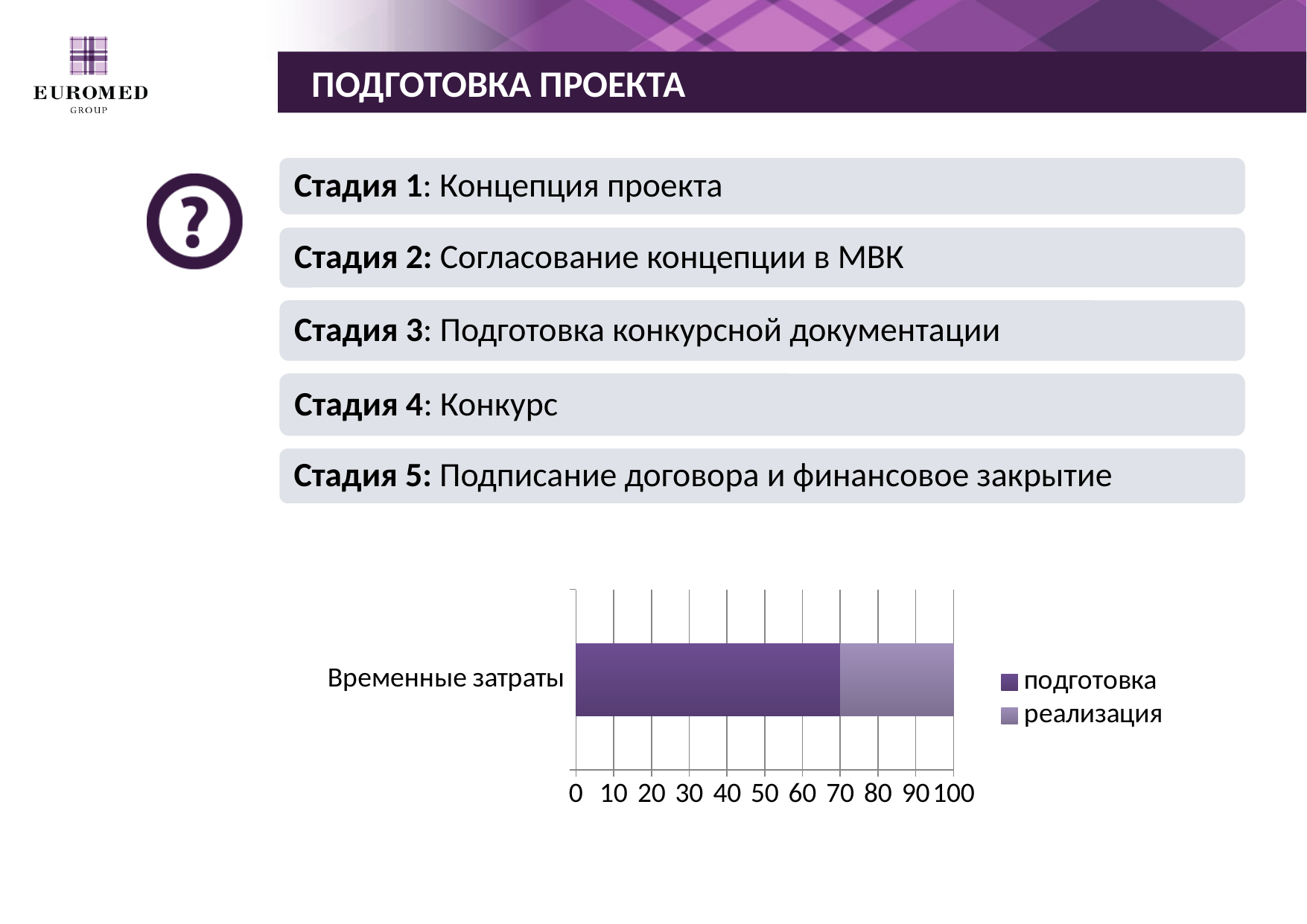
Is the value of the подготовка segment greater or less than 50? greater What is the value of the подготовка segment for Временные затраты? 70 What is the maximum value shown on the chart's horizontal axis? 100 How many categories are plotted on the chart? 1 Which legend entry is shown in the darker purple colour? подготовка How many series does the chart legend list? 2 What is the label of the single category on the chart's vertical axis? Временные затраты Which series has the larger segment in the Временные затраты bar, подготовка or реализация? подготовка What kind of chart is shown on the slide? bar chart Is the value of the реализация segment greater or less than 50? less What is the total length of the stacked bar for Временные затраты? 100